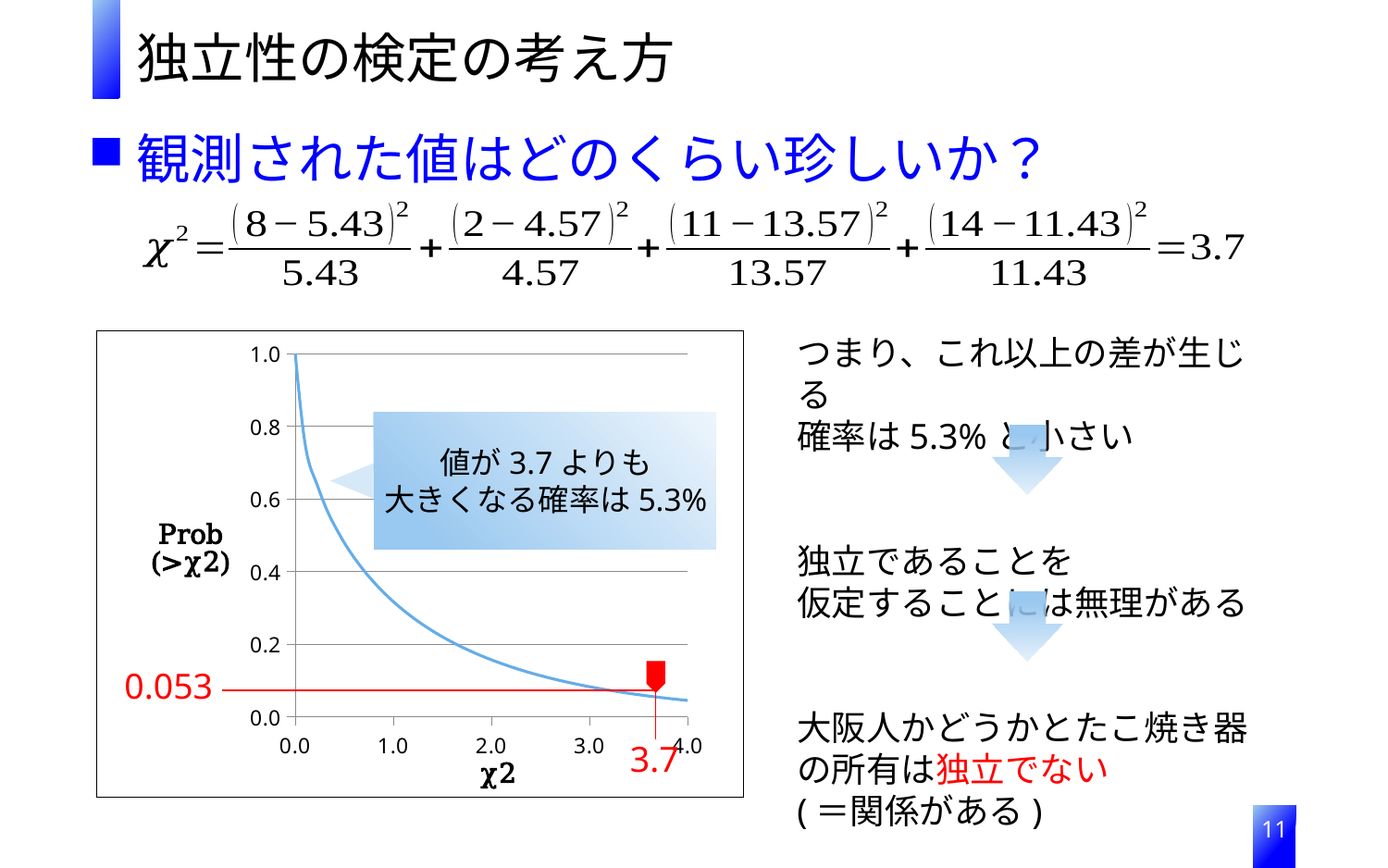
Which is larger: the curve's value at χ2 = 1.0 or at χ2 = 3.0? χ2 = 1.0 According to the callout on the chart, what is the probability that the value exceeds 3.7? 5.3% What is the highest tick value shown on the x axis? 4.0 Is the value of the curve at χ2 = 0.5 greater or less than 0.4? greater What is the value of the curve at χ2 = 0.0? 1.0 Does the plotted curve rise or fall as χ2 increases along the x axis? fall What kind of chart is shown on the slide? line chart Is the value of the curve at χ2 = 3.0 greater or less than 0.2? less What probability value is marked on the chart at χ2 = 3.7? 0.053 At what χ2 value is the red marker placed on the chart? 3.7 Is the value of the curve at χ2 = 1.0 greater or less than 0.4? less What is the label of the x axis of the chart? χ2